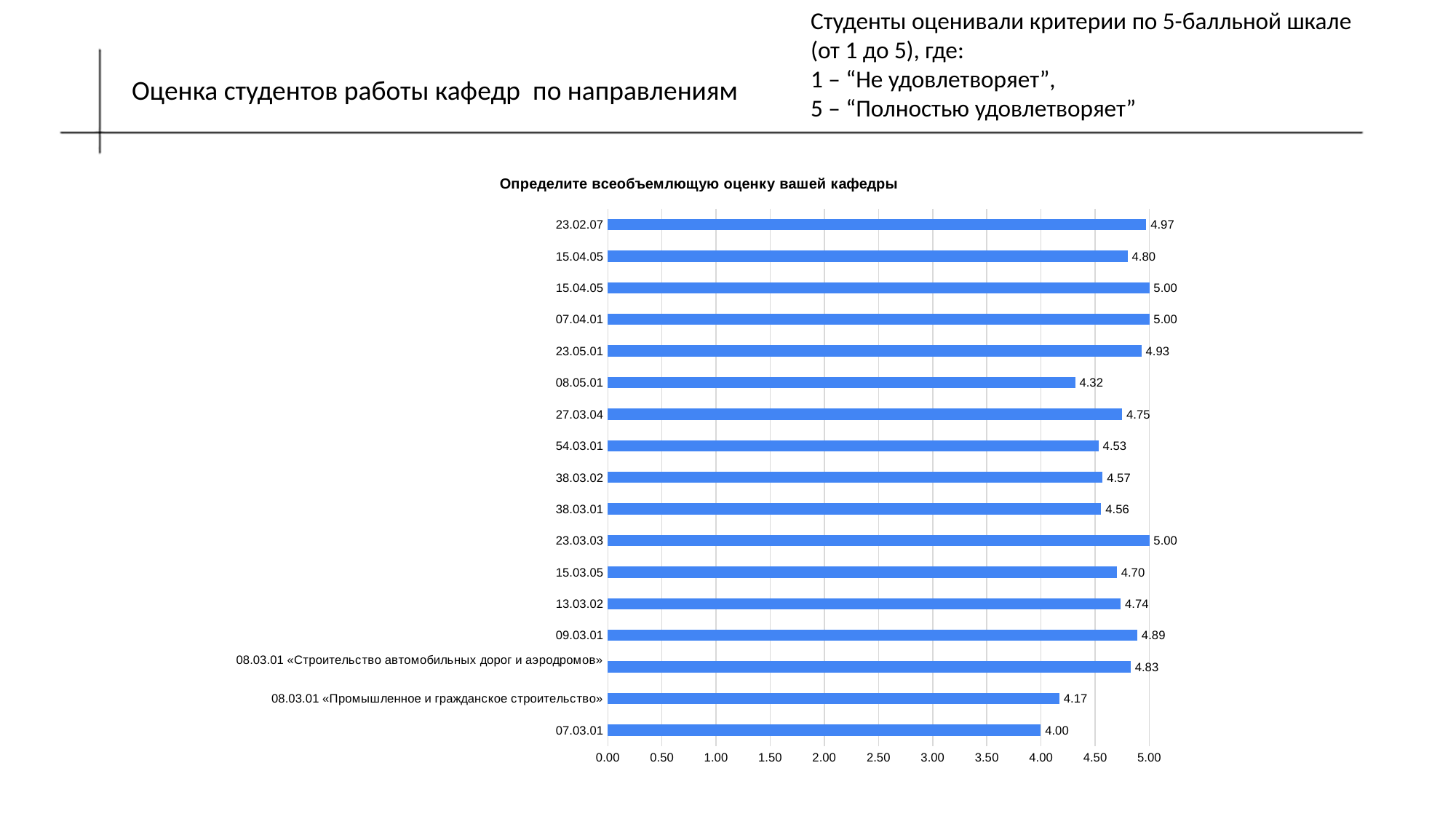
What is the value for 09.03.01? 4.89 What is the title of the chart? Определите всеобъемлющую оценку вашей кафедры What kind of chart is shown on the slide? bar chart Which category has the lowest value? 07.03.01 What is the difference between the values for 23.05.01 and 08.05.01? 0.61 What is the value for 08.05.01? 4.32 What is the value for 08.03.01 «Промышленное и гражданское строительство»? 4.17 Which is larger, the value for 27.03.04 or the value for 54.03.01? 27.03.04 What is the difference between the values for 08.03.01 «Строительство автомобильных дорог и аэродромов» and 08.03.01 «Промышленное и гражданское строительство»? 0.66 How many categories are shown in the chart? 17 What is the value for 23.02.07? 4.97 Is the value for 07.03.01 greater or less than 4.50? less